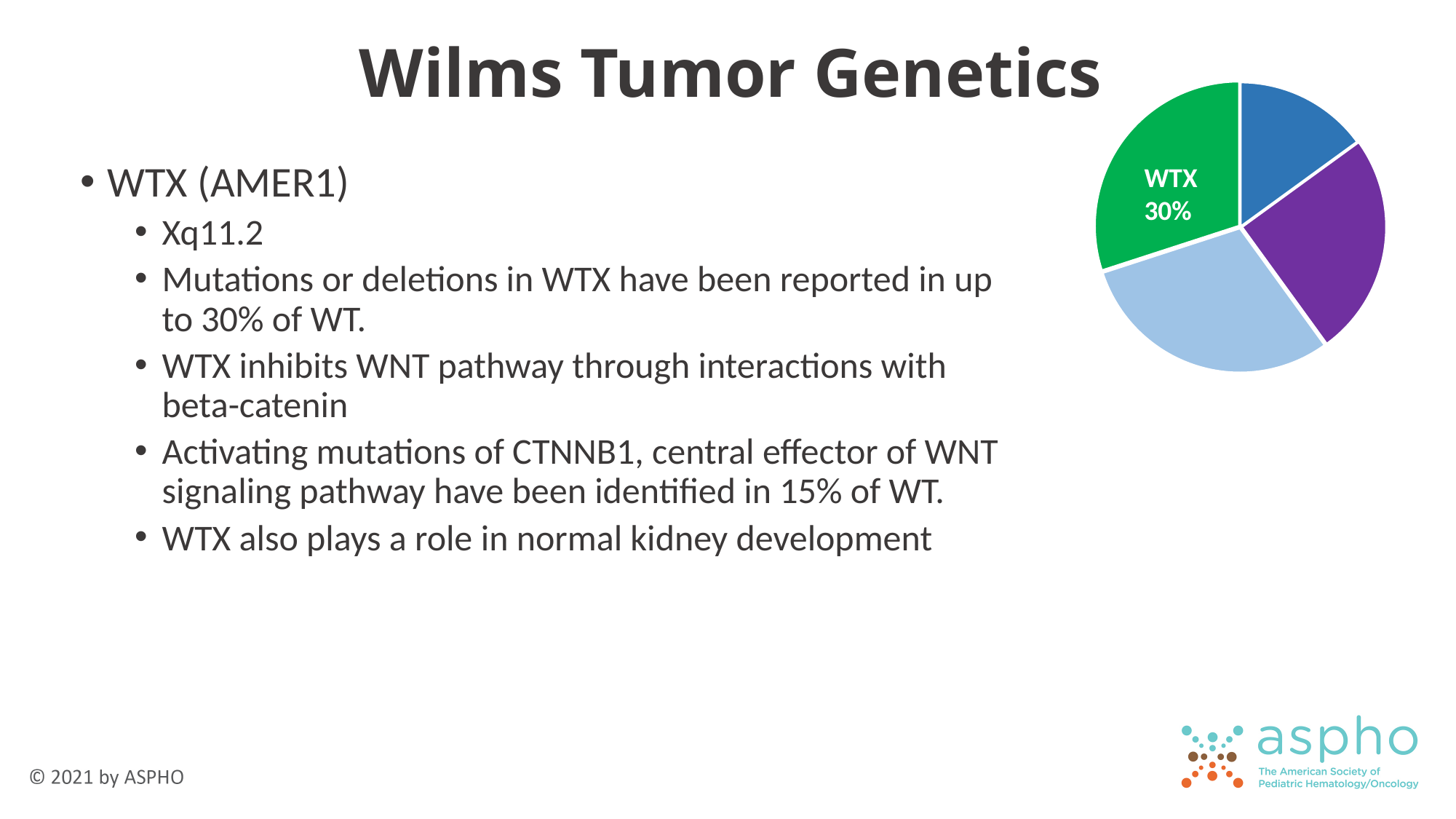
What kind of chart is shown on the slide? pie chart How many slices does the pie chart have? 4 What percentage is shown for the WTX slice of the pie chart? 30% Which slice of the pie chart is labeled with a value? WTX What share of the pie does the WTX slice represent? 30% What colour is the WTX slice in the pie chart? green